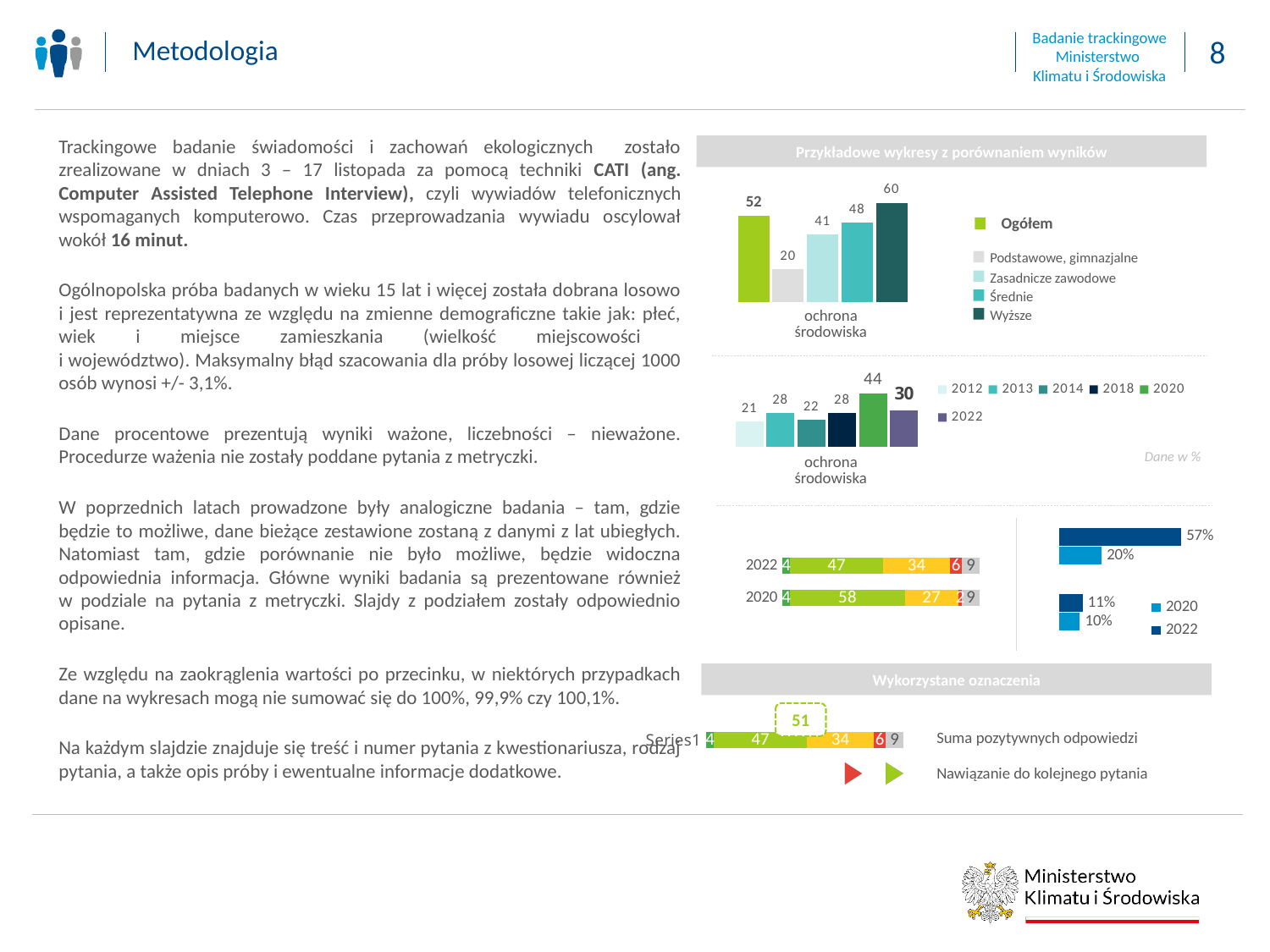
In the stacked bar chart comparing 2022 and 2020, what is the difference between the yellow segments for 2022 and 2020? 7 In the middle-right bar chart by year (ochrona środowiska), what is the value for 2020? 44 What type of chart is the top-right chart by education level? bar chart In the top-right bar chart by education level (ochrona środowiska), what is the value for Wyższe? 60 In the middle-right bar chart by year, which is larger, the value for 2022 or the value for 2014? 2022 In the middle-right bar chart by year, how many years does the legend list? 6 In the middle-right bar chart by year (ochrona środowiska), which year has the highest value? 2020 In the top-right bar chart by education level, how many series does the legend list? 5 In the top-right bar chart by education level, which category has the lowest value? Podstawowe, gimnazjalne In the top-right bar chart by education level, what is the difference between Wyższe and Podstawowe, gimnazjalne? 40 In the top-right bar chart by education level (ochrona środowiska), what is the value for Ogółem? 52 In the stacked bar chart comparing 2022 and 2020, what is the value of the largest (green) segment for 2020? 58